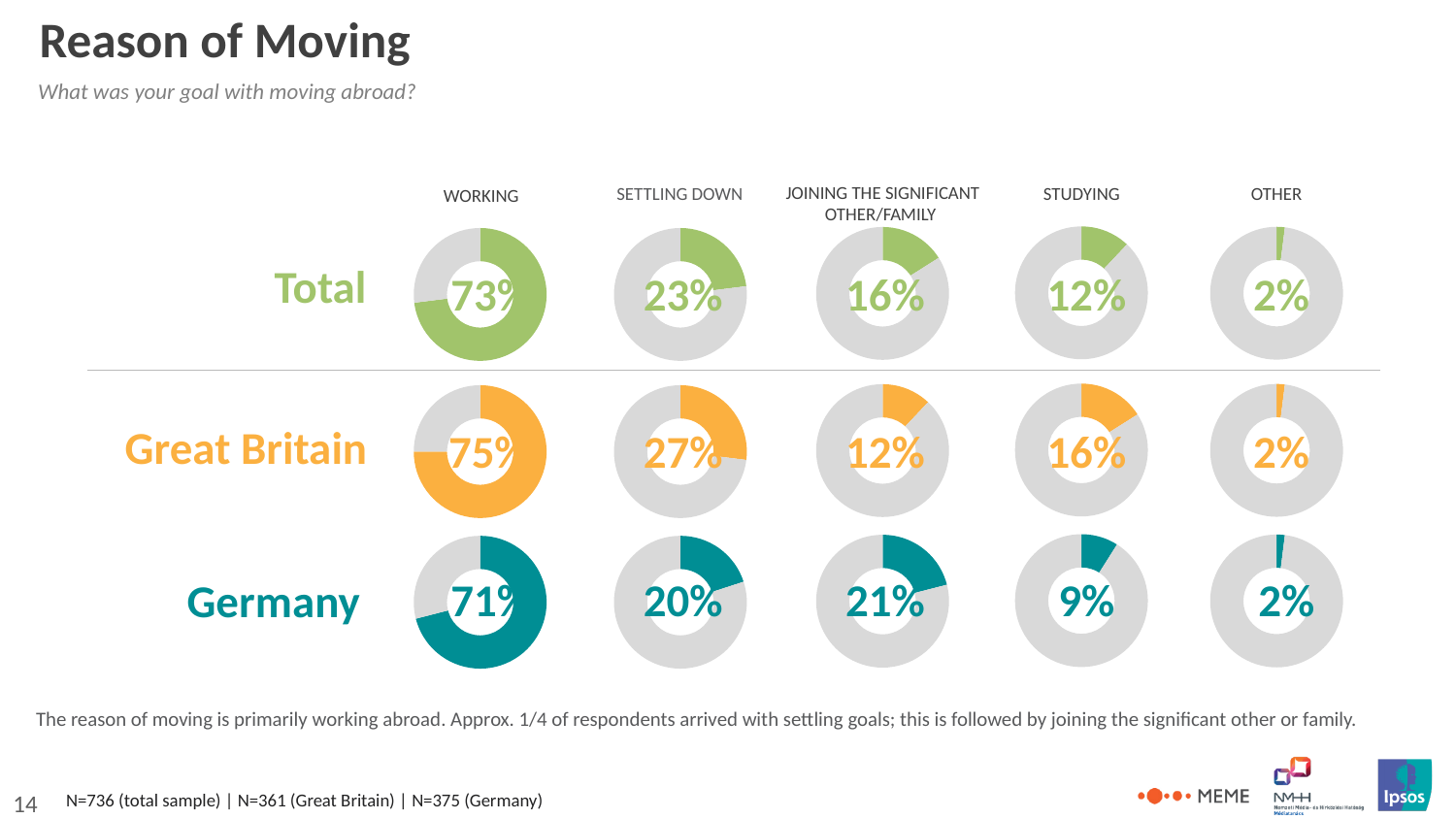
In the Great Britain row, what percentage is shown for Settling Down? 27% In the Great Britain row, what percentage is shown for Studying? 16% What type of charts are used on this slide? Donut (pie) charts What is the difference between the Working percentage for Great Britain and for Germany? 4% How many reasons for moving are shown as columns on the slide? 5 In the Total row, which reason has the lowest percentage? Other For Studying, which is larger: the Great Britain value or the Germany value? Great Britain In the Germany row, what percentage is shown for Joining the Significant Other/Family? 21% What colour is used for the Germany row of charts? Teal How many groups (rows) are compared on the slide? 3 In the Germany row, which reason has the highest percentage? Working In the Total row, what percentage is shown for Working? 73%